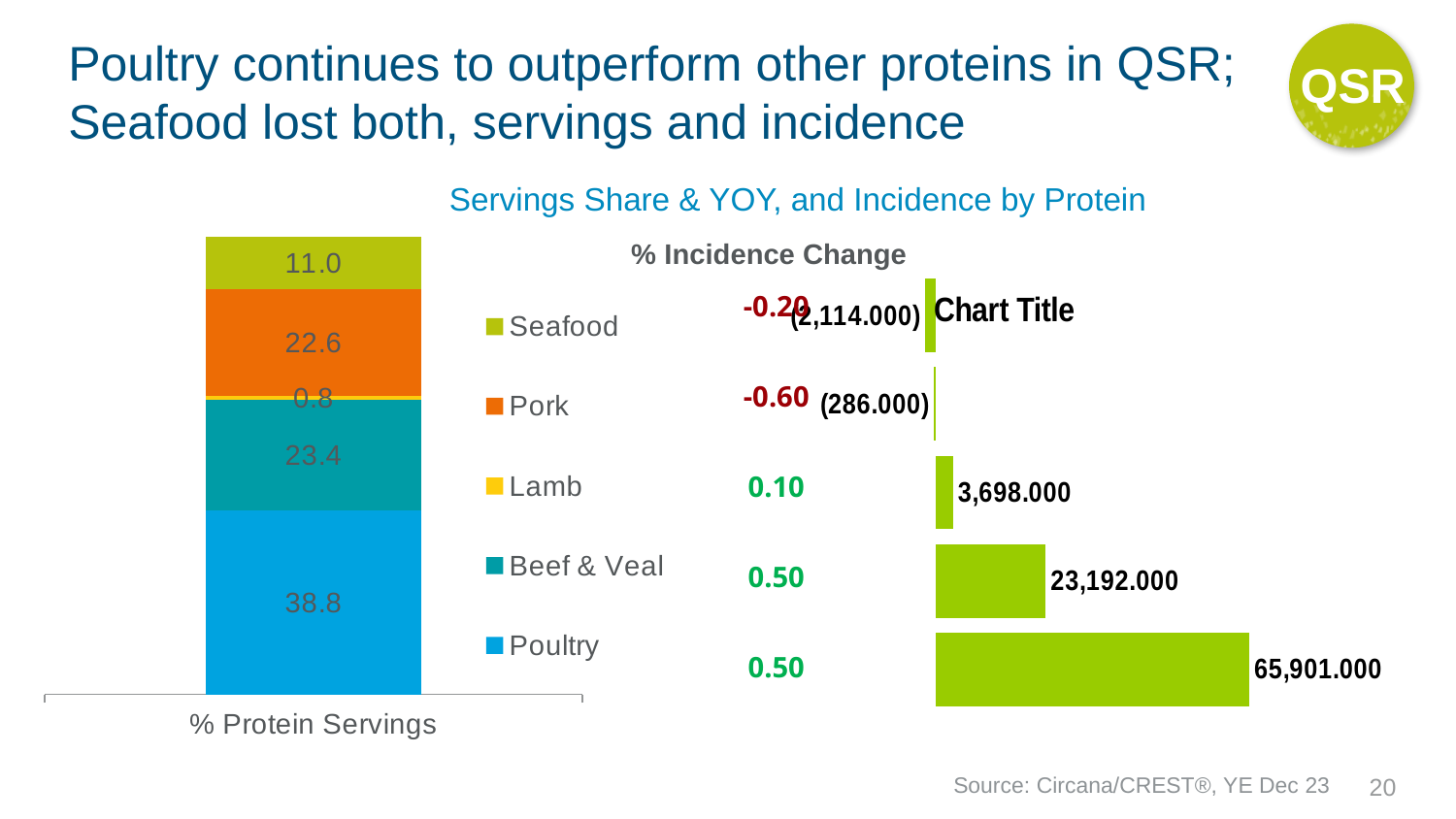
In the stacked bar chart on the left, what is the total of all the segments in the bar? 96.6 In the stacked bar chart on the left, what is the value of the Seafood segment? 11.0 What kind of chart is the chart on the left of the slide? Stacked bar chart In the stacked bar chart on the left, what is the value of the Poultry segment? 38.8 In the stacked bar chart on the left, which protein has the largest segment? Poultry How many proteins does the legend list? 5 In the stacked bar chart on the left, what is the difference between the Poultry and Beef & Veal segments? 15.4 In the stacked bar chart on the left, which segment is larger, Pork or Seafood? Pork In the stacked bar chart on the left, what is the value of the Pork segment? 22.6 In the stacked bar chart on the left, which protein has the smallest segment? Lamb In the bar chart on the right titled 'Chart Title', what is the value shown on the longest bar? 65,901.000 What is the axis label shown under the stacked bar chart on the left? % Protein Servings